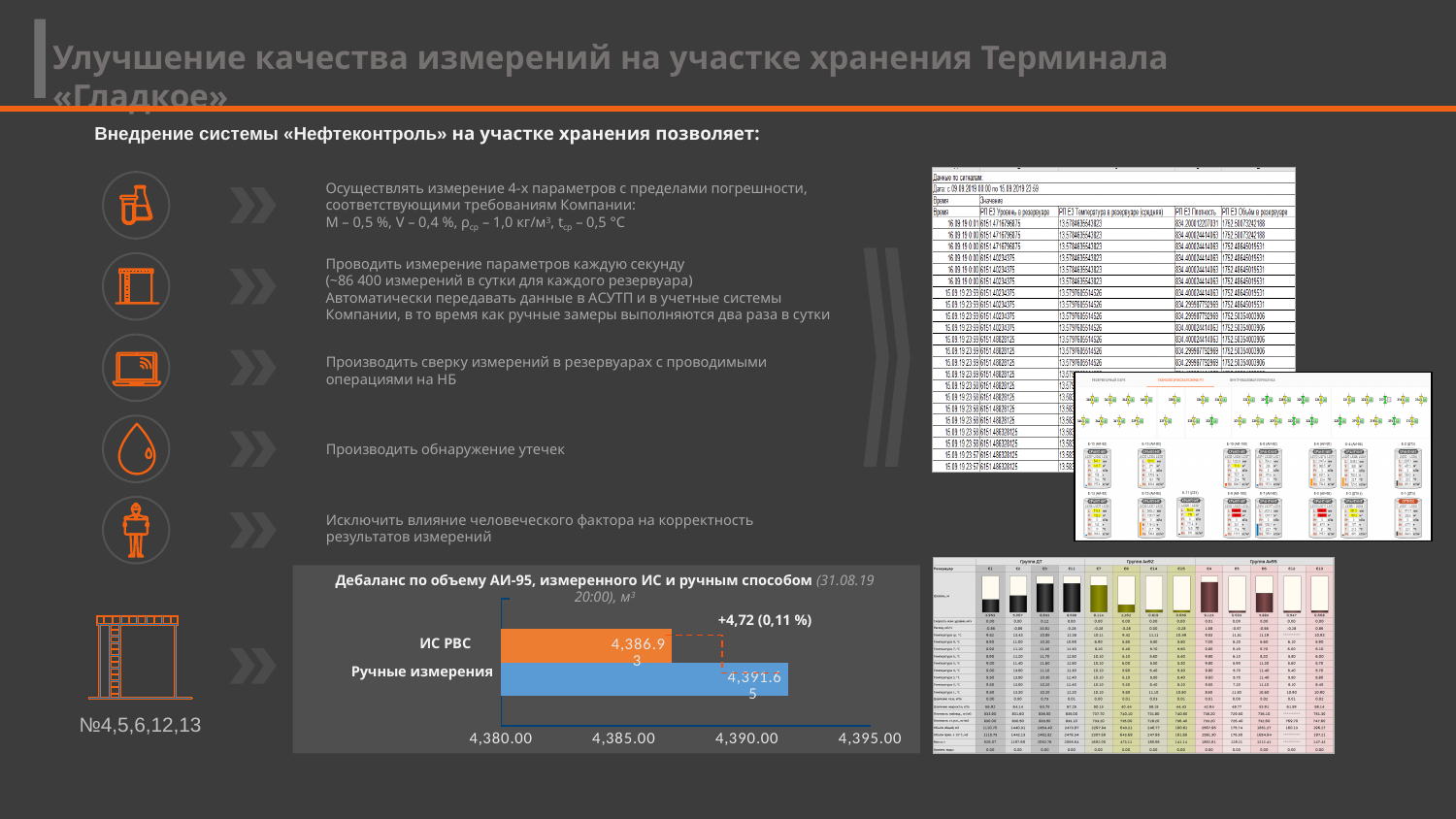
Is the value for ИС РВС greater or less than the value for Ручные измерения? less Which category has the lower value in the bar chart? ИС РВС What type of chart is shown at the bottom of the slide? bar chart What percentage difference is annotated on the bar chart? 0,11 % Which category has the higher value in the bar chart? Ручные измерения Is the value for Ручные измерения greater or less than 4,390.00? greater What unit is given in the title of the bar chart? м³ What is the difference between the values for Ручные измерения and ИС РВС? 4.72 What is the value for Ручные измерения in the bar chart? 4,391.65 What is the value for ИС РВС in the bar chart? 4,386.93 Is the value for ИС РВС greater or less than 4,390.00? less How many categories are plotted in the bar chart? 2